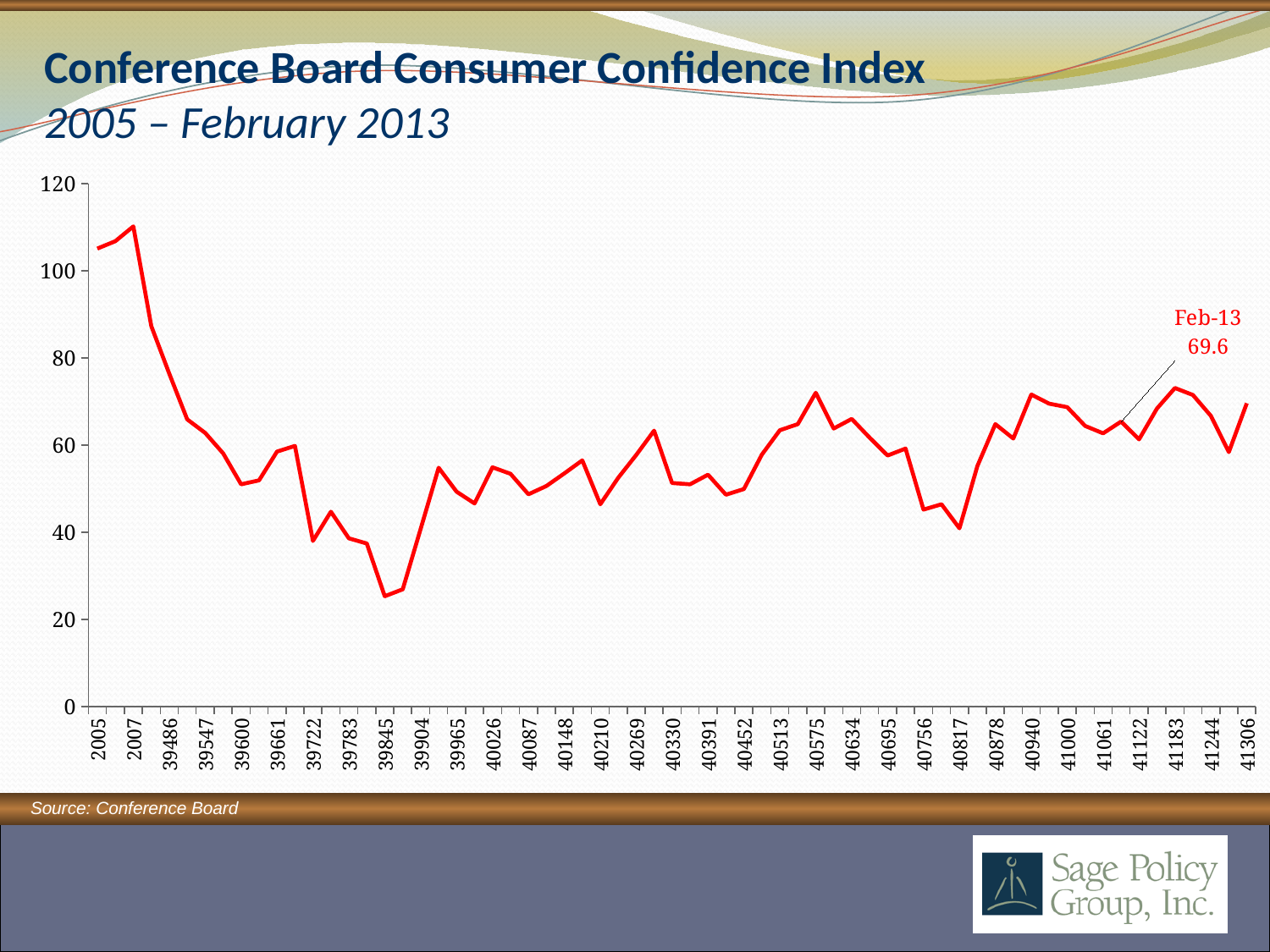
Which is larger, the value for 2005 or the value for 41306 (Feb-13)? 2005 Is the value for 40575 greater or less than 60? greater What is the value of the Consumer Confidence Index labelled for Feb-13? 69.6 What kind of chart is shown on the slide? Line chart What is the title of the chart on the slide? Conference Board Consumer Confidence Index 2005 – February 2013 Which x-axis label corresponds to the highest point on the line? 2007 Is the value for 40817 greater or less than 60? less Does the line rise or fall between 2007 and 39486? Fall Is the value for 2005 greater or less than 100? greater Which x-axis label corresponds to the lowest point on the line? 39845 What source is cited for the chart? Conference Board